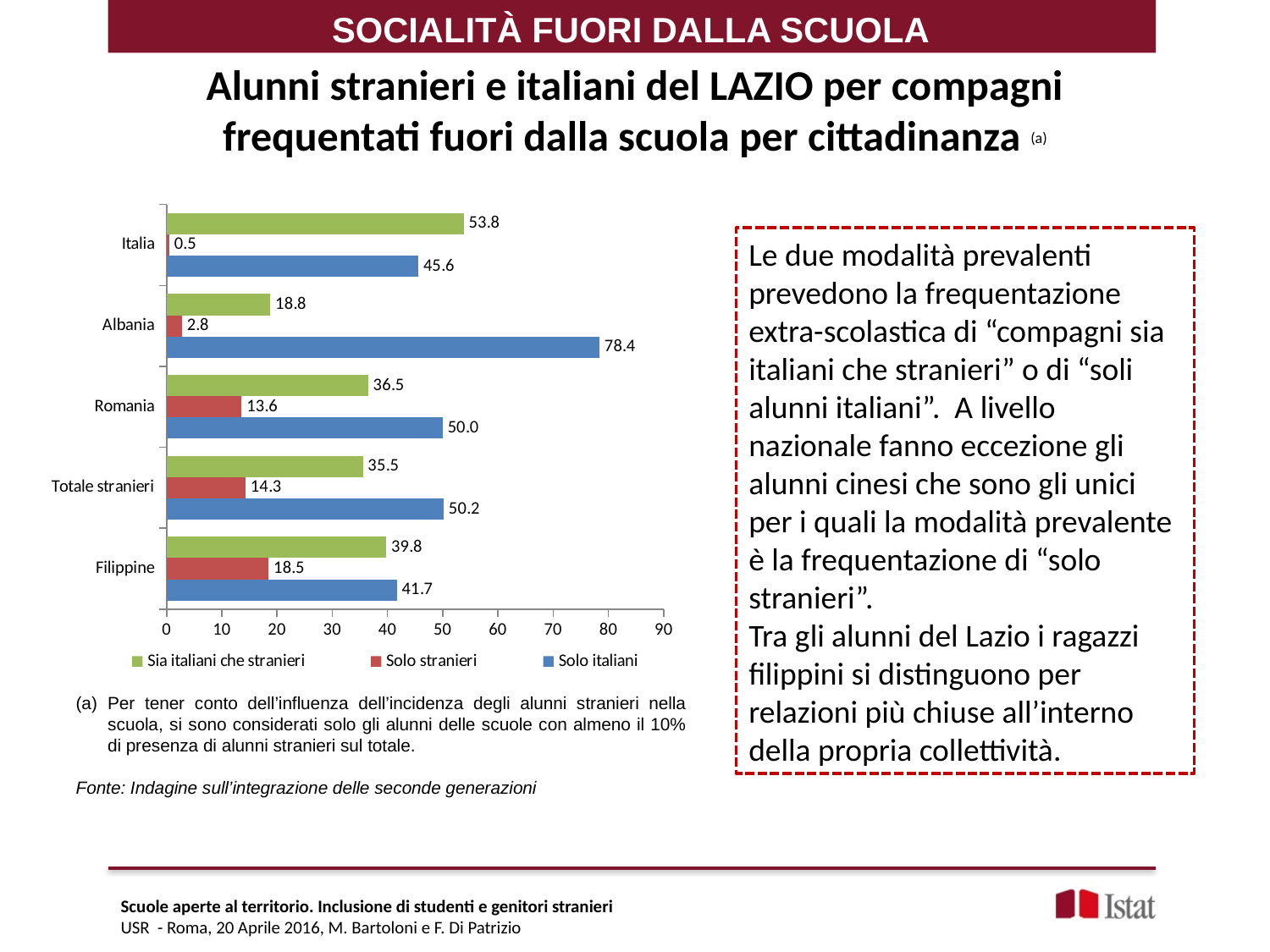
What is the value of 'Sia italiani che stranieri' for Italia? 53.8 How many categories are shown on the y axis of the chart? 5 What is the value of 'Solo italiani' for Albania? 78.4 Which category has the highest 'Solo italiani' value? Albania Which category has the lowest 'Solo stranieri' value? Italia How many series does the legend list? 3 What kind of chart is shown on the slide? Bar chart What is the difference between the 'Solo italiani' value for Albania and for Italia? 32.8 Is the 'Solo italiani' value for Romania greater or less than 40? greater Which colour represents the 'Solo stranieri' series? Red Which is larger for Filippine: 'Sia italiani che stranieri' or 'Solo italiani'? Solo italiani What is the value of 'Solo stranieri' for Filippine? 18.5